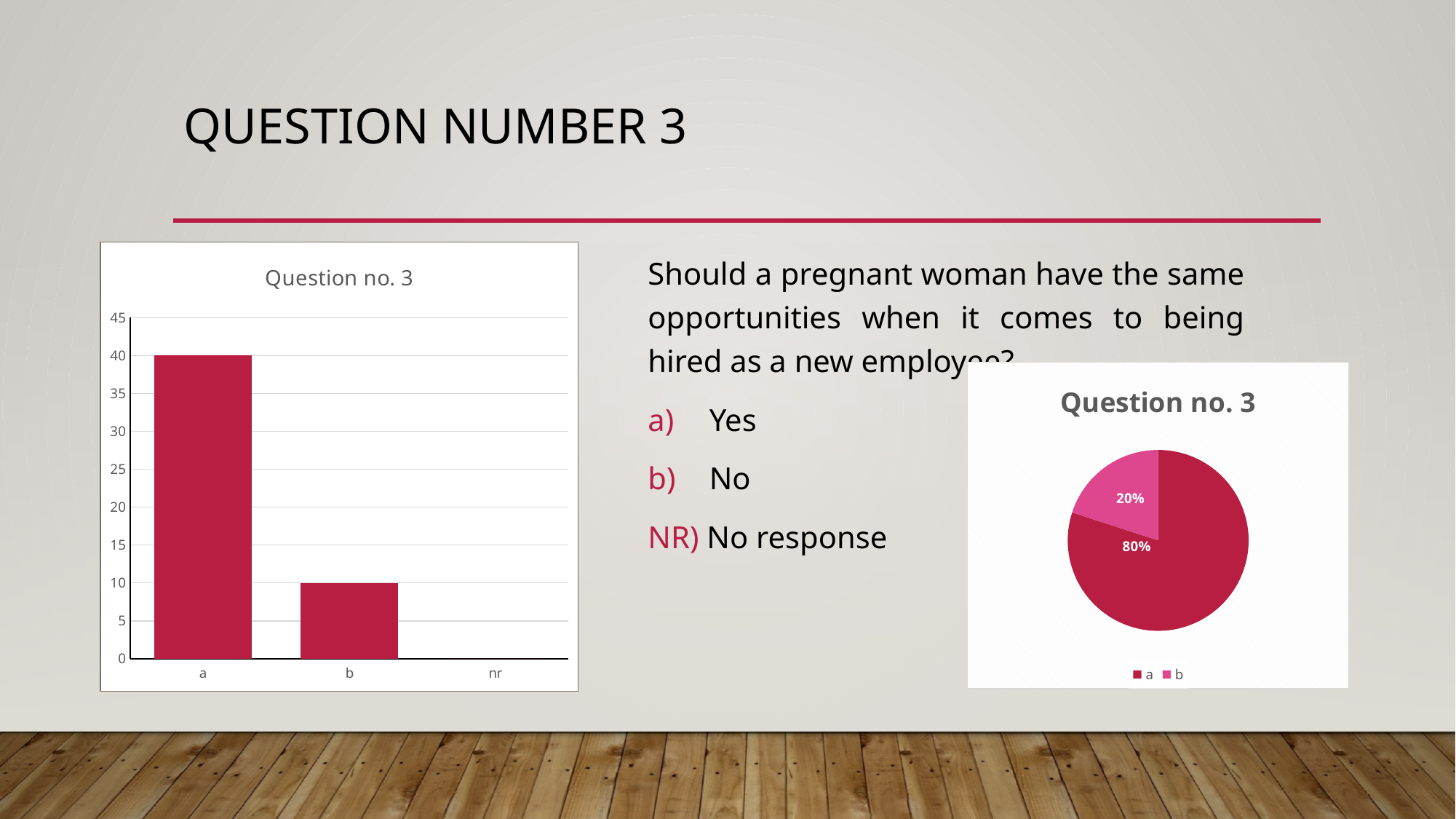
In the pie chart on the right, which slice is larger, a or b? a In the pie chart on the right, what share does slice b have? 20% What kind of chart is the chart on the left of the slide? bar chart In the bar chart on the left, what is the value for category a? 40 In the bar chart on the left, which category has the lowest value? nr In the pie chart on the right, what share does slice a have? 80% In the bar chart on the left, what is the difference between the values for a and b? 30 In the bar chart on the left, is the value for b greater or less than 20? less How many categories are shown on the x axis of the bar chart on the left? 3 In the bar chart on the left, what is the value for category b? 10 How many entries does the legend of the pie chart on the right list? 2 In the bar chart on the left, which category has the highest value? a